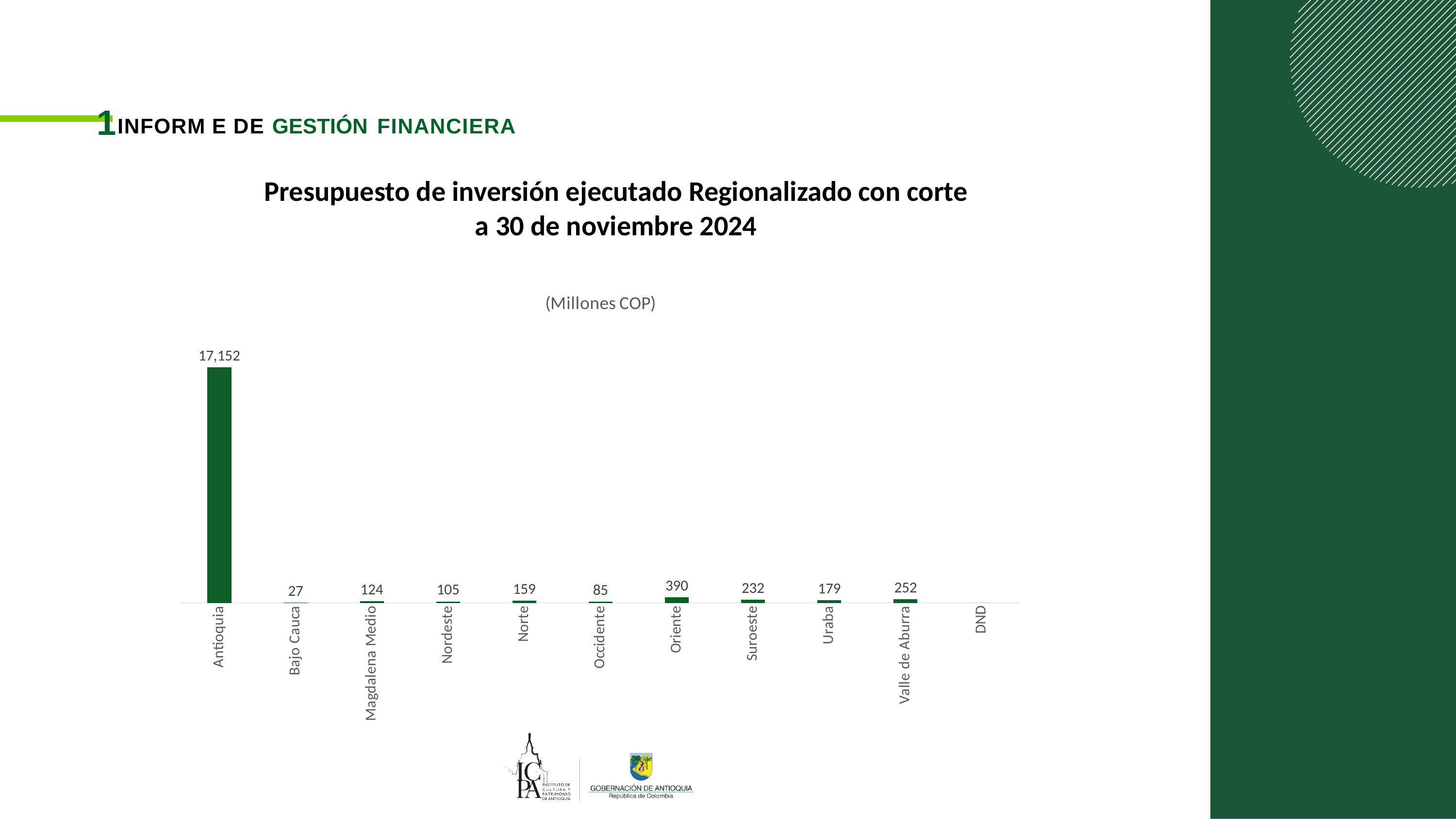
What is the value for Antioquia? 17,152 What is the value for Magdalena Medio? 124 What is the value for Bajo Cauca? 27 What is the difference between the values for Oriente and Suroeste? 158 How many categories are shown on the x axis? 11 What is the difference between the values for Valle de Aburra and Uraba? 73 What unit is stated in the chart subtitle? Millones COP Which category has the highest value? Antioquia What kind of chart is shown on the slide? Bar chart What is the value for Valle de Aburra? 252 Which is larger, the value for Norte or the value for Occidente? Norte What is the value for Oriente? 390